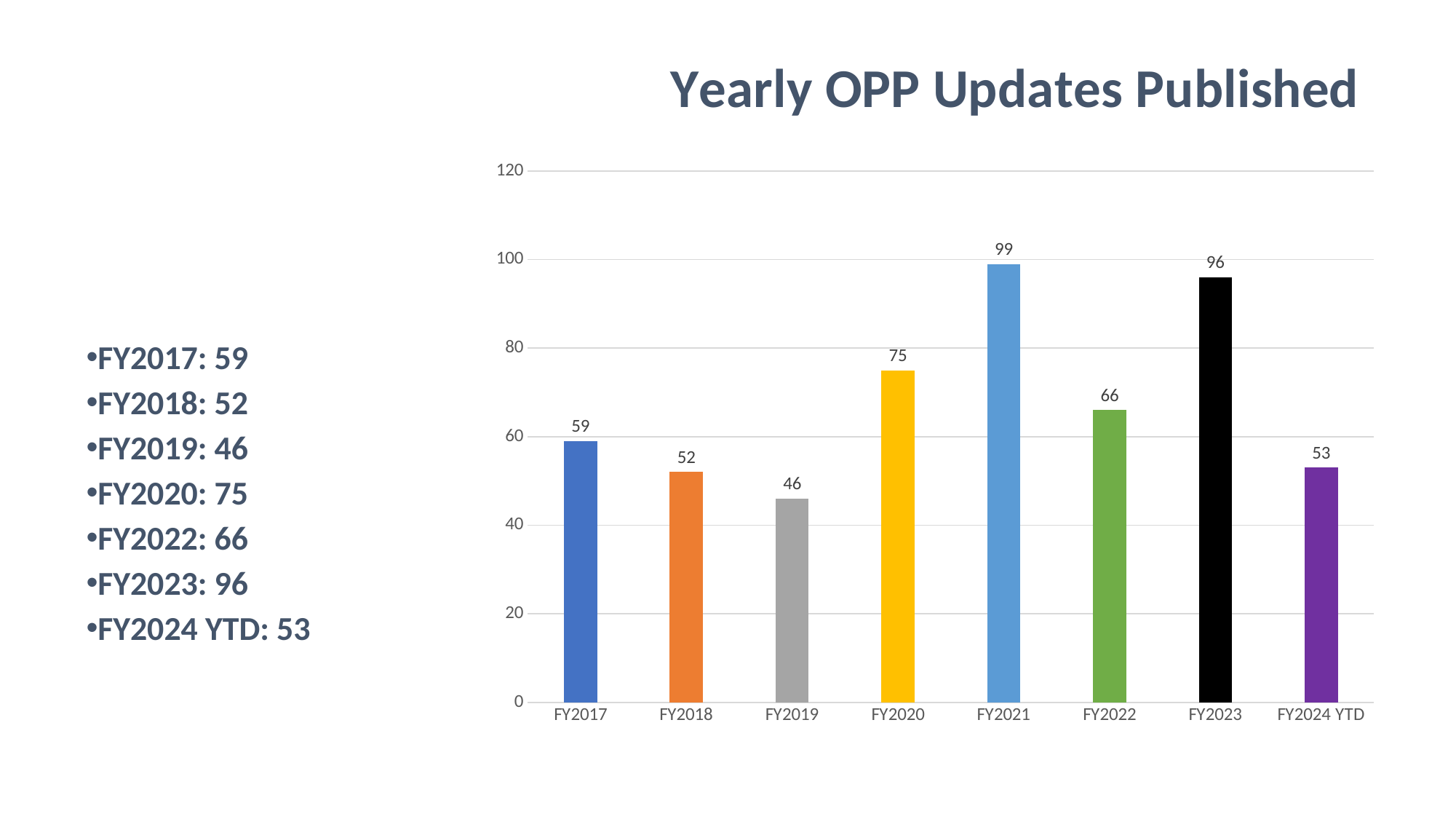
What is the difference between the values for FY2020 and FY2019? 29 Which fiscal year has the highest number of OPP updates published? FY2021 What is the title of the chart on the slide? Yearly OPP Updates Published Is the value for FY2022 greater or less than 60? greater What is the value for FY2019 in the Yearly OPP Updates Published chart? 46 Which is larger, the value for FY2017 or the value for FY2018? FY2017 What is the value for FY2021 in the Yearly OPP Updates Published chart? 99 How many fiscal year categories are shown on the x axis of the chart? 8 What is the value for FY2024 YTD in the Yearly OPP Updates Published chart? 53 Which fiscal year has the lowest number of OPP updates published? FY2019 What is the difference between the values for FY2021 and FY2023? 3 What kind of chart is shown on the slide? Bar chart